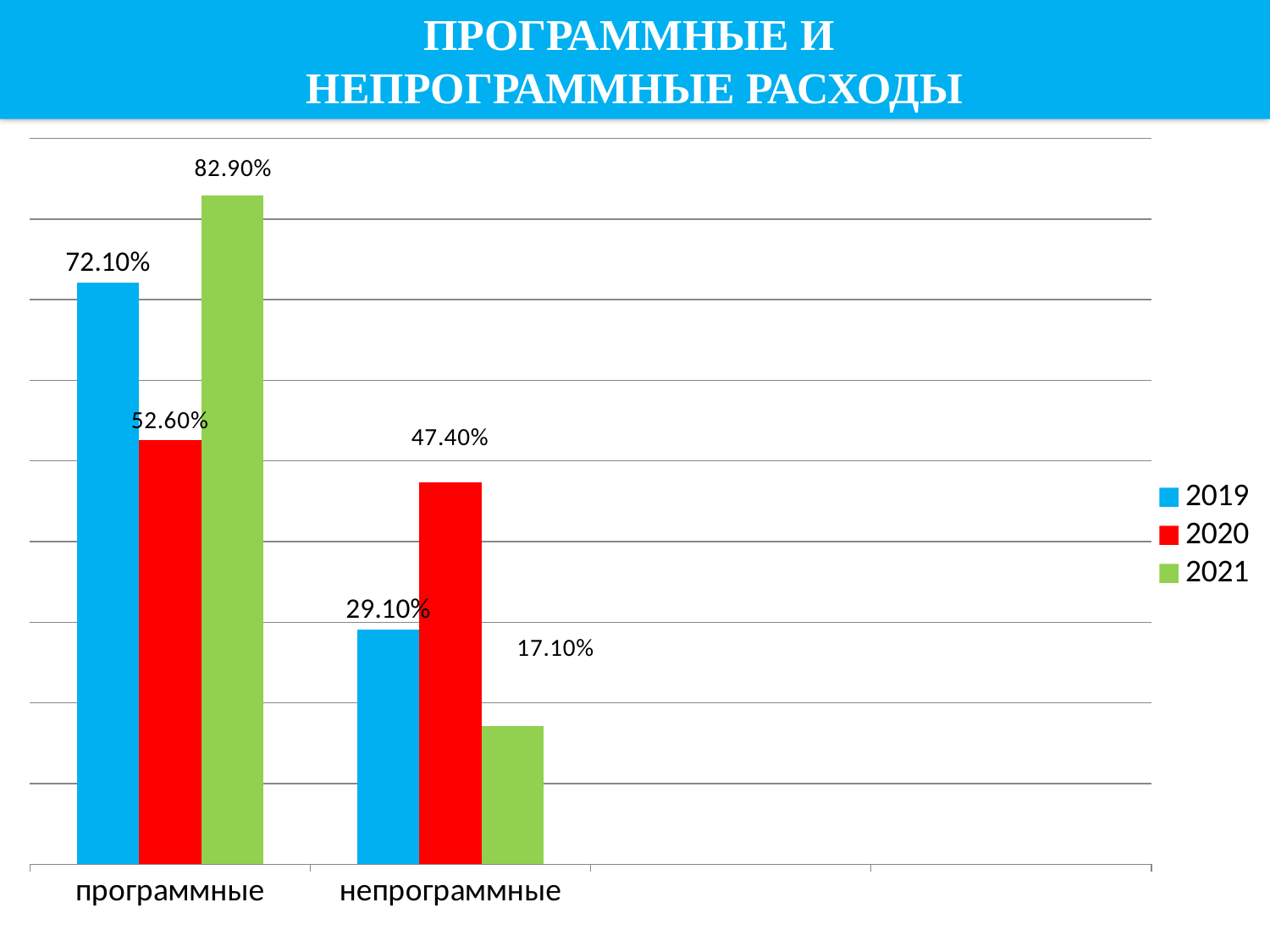
What is the difference between the 2020 and 2019 values for непрограммные? 18.30% What is the value for программные in 2021? 82.90% Which year has the highest value for программные? 2021 What is the difference between the 2021 and 2019 values for программные? 10.80% How many categories are shown on the x axis? 2 Which year has the lowest value for непрограммные? 2021 What is the value for непрограммные in 2020? 47.40% What kind of chart is shown on the slide? bar chart How many series does the legend list? 3 Which is larger: the 2020 value for программные or the 2020 value for непрограммные? программные What is the value for непрограммные in 2021? 17.10% What is the value for программные in 2019? 72.10%